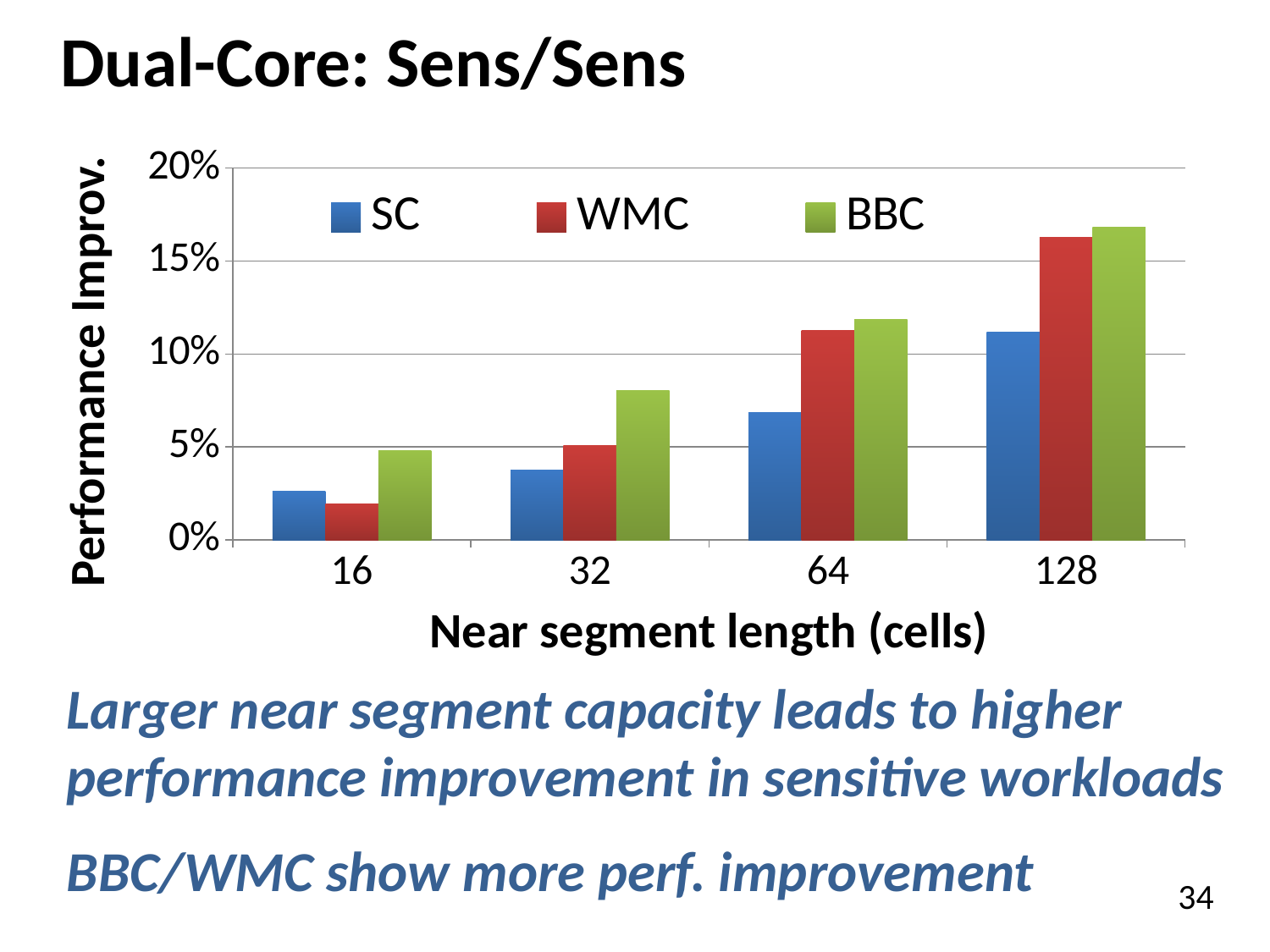
At near segment length 16, which series has the larger value, SC or WMC? SC How many series does the legend list? 3 At which near segment length does BBC reach its highest performance improvement? 128 What kind of chart is shown on the slide? bar chart Is the BBC value at near segment length 32 greater or less than 10%? less Is the WMC value at near segment length 16 greater or less than 5%? less What is the label of the x axis? Near segment length (cells) Is the BBC value at near segment length 128 greater or less than 15%? greater Do the SC values rise or fall as near segment length increases from 16 to 128? rise How many near segment length categories are shown on the x axis? 4